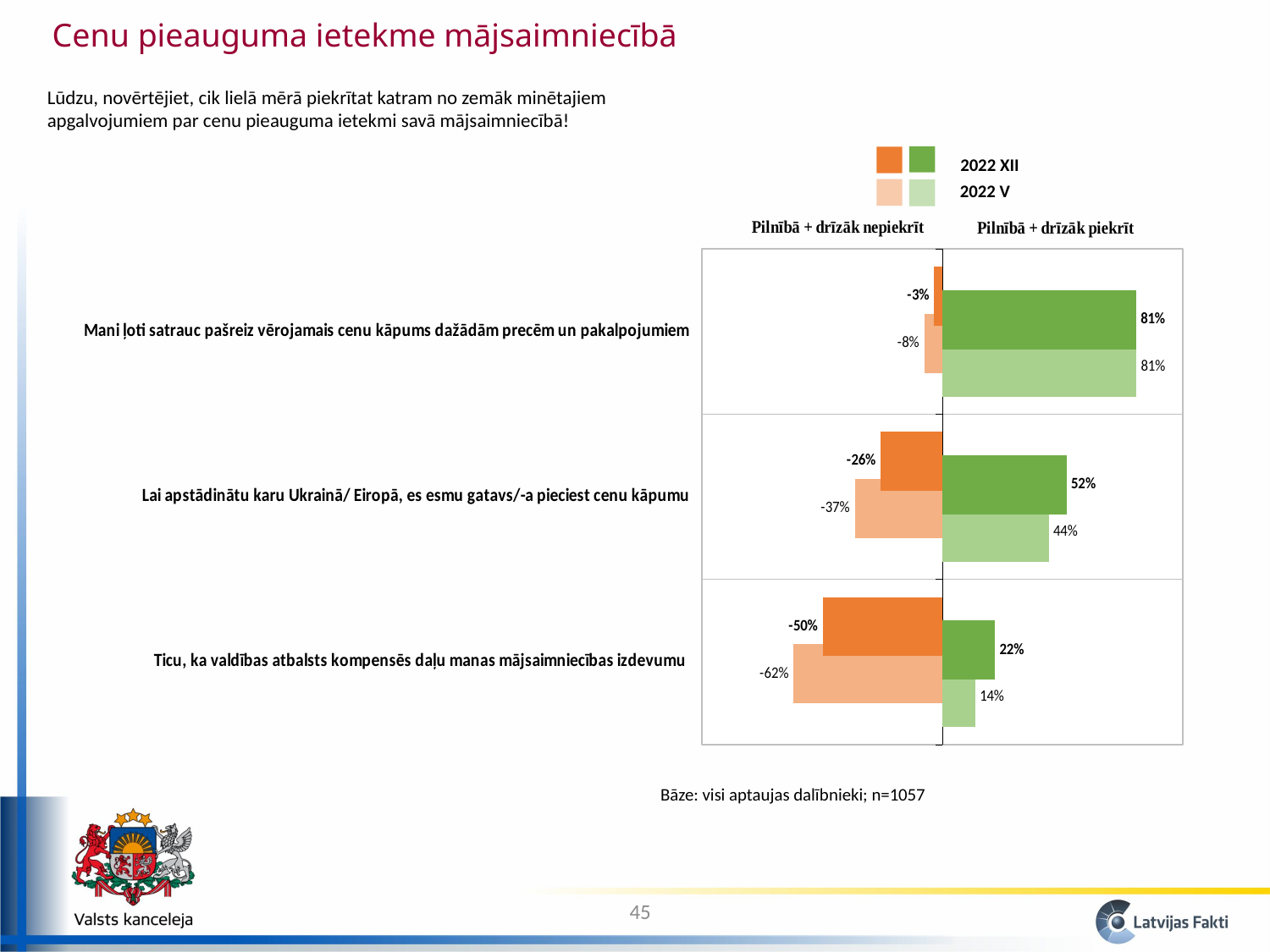
What share of respondents agreed (Pilnībā + drīzāk piekrīt) in 2022 XII with the statement "Mani ļoti satrauc pašreiz vērojamais cenu kāpums dažādām precēm un pakalpojumiem"? 81% How many statements are shown in the chart? 3 What type of chart is shown on the slide? Bar chart By how many percentage points did agreement with "Lai apstādinātu karu Ukrainā/ Eiropā, es esmu gatavs/-a pieciest cenu kāpumu" change from 2022 V (44%) to 2022 XII (52%)? 8 percentage points What is the base (n) of the survey stated below the chart? n=1057 What is the 2022 V disagreement value for the statement "Lai apstādinātu karu Ukrainā/ Eiropā, es esmu gatavs/-a pieciest cenu kāpumu"? -37% What share of respondents disagreed (Pilnībā + drīzāk nepiekrīt) in 2022 V with the statement "Ticu, ka valdības atbalsts kompensēs daļu manas mājsaimniecības izdevumu"? -62% How many survey waves does the legend list? 2 Which statement has the highest 2022 XII agreement share? Mani ļoti satrauc pašreiz vērojamais cenu kāpums dažādām precēm un pakalpojumiem Which statement has the lowest 2022 V agreement share? Ticu, ka valdības atbalsts kompensēs daļu manas mājsaimniecības izdevumu What is the 2022 XII agreement value for the statement "Lai apstādinātu karu Ukrainā/ Eiropā, es esmu gatavs/-a pieciest cenu kāpumu"? 52% For the statement "Ticu, ka valdības atbalsts kompensēs daļu manas mājsaimniecības izdevumu", which is larger: the 2022 XII agreement share or the 2022 V agreement share? 2022 XII (22%)